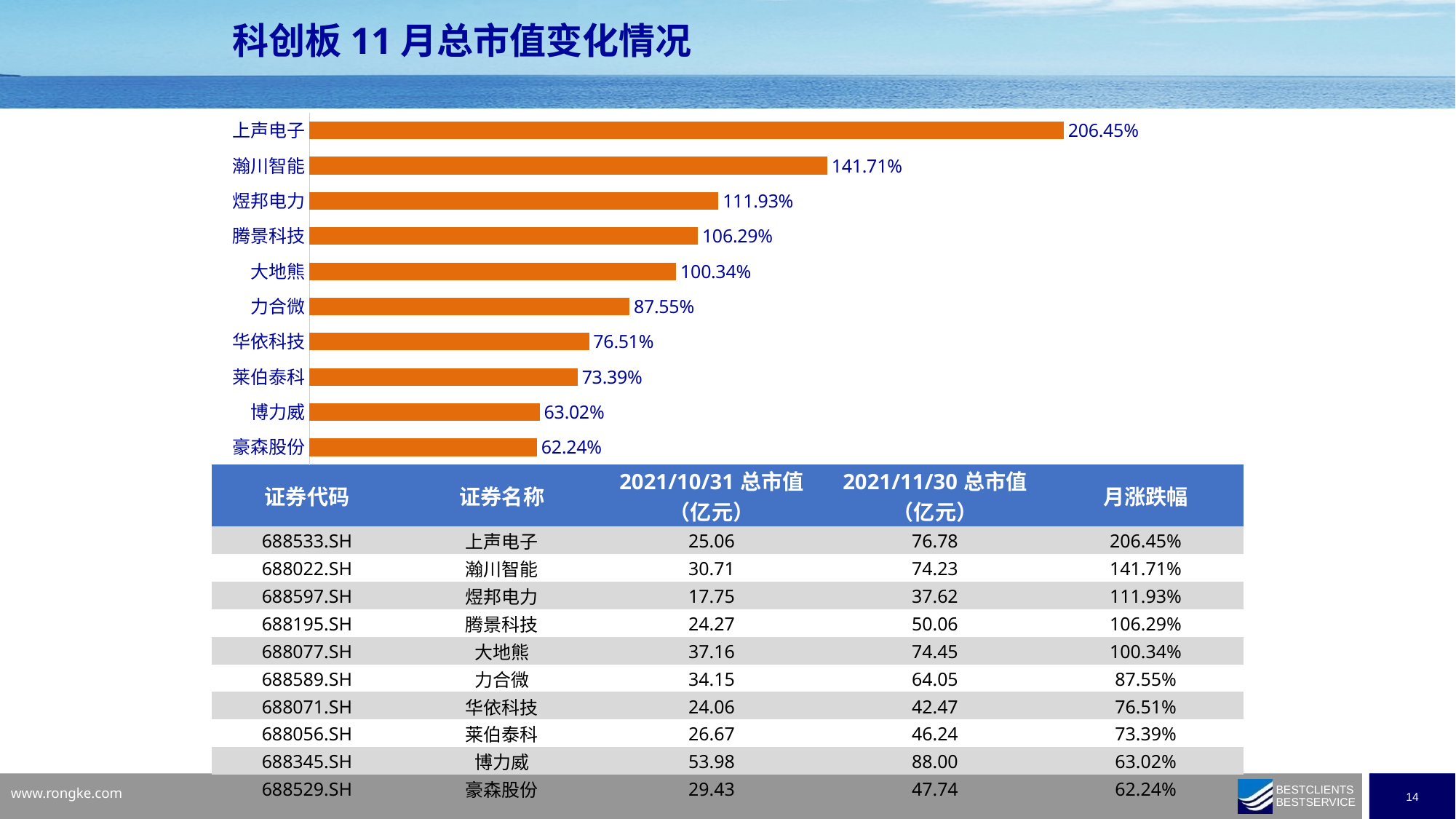
Which is larger, the value for 煜邦电力 or the value for 腾景科技? 煜邦电力 Do the values rise or fall going from the top bar to the bottom bar? fall What is the value for 上声电子? 206.45% Which category has the highest value? 上声电子 What colour are the bars in the chart? orange How many categories are shown in the bar chart? 10 What is the difference between the values for 力合微 and 华依科技? 11.04% What kind of chart is shown on the slide? bar chart Which category has the lowest value? 豪森股份 What is the value for 大地熊? 100.34% What is the difference between the values for 上声电子 and 瀚川智能? 64.74% What is the value for 豪森股份? 62.24%